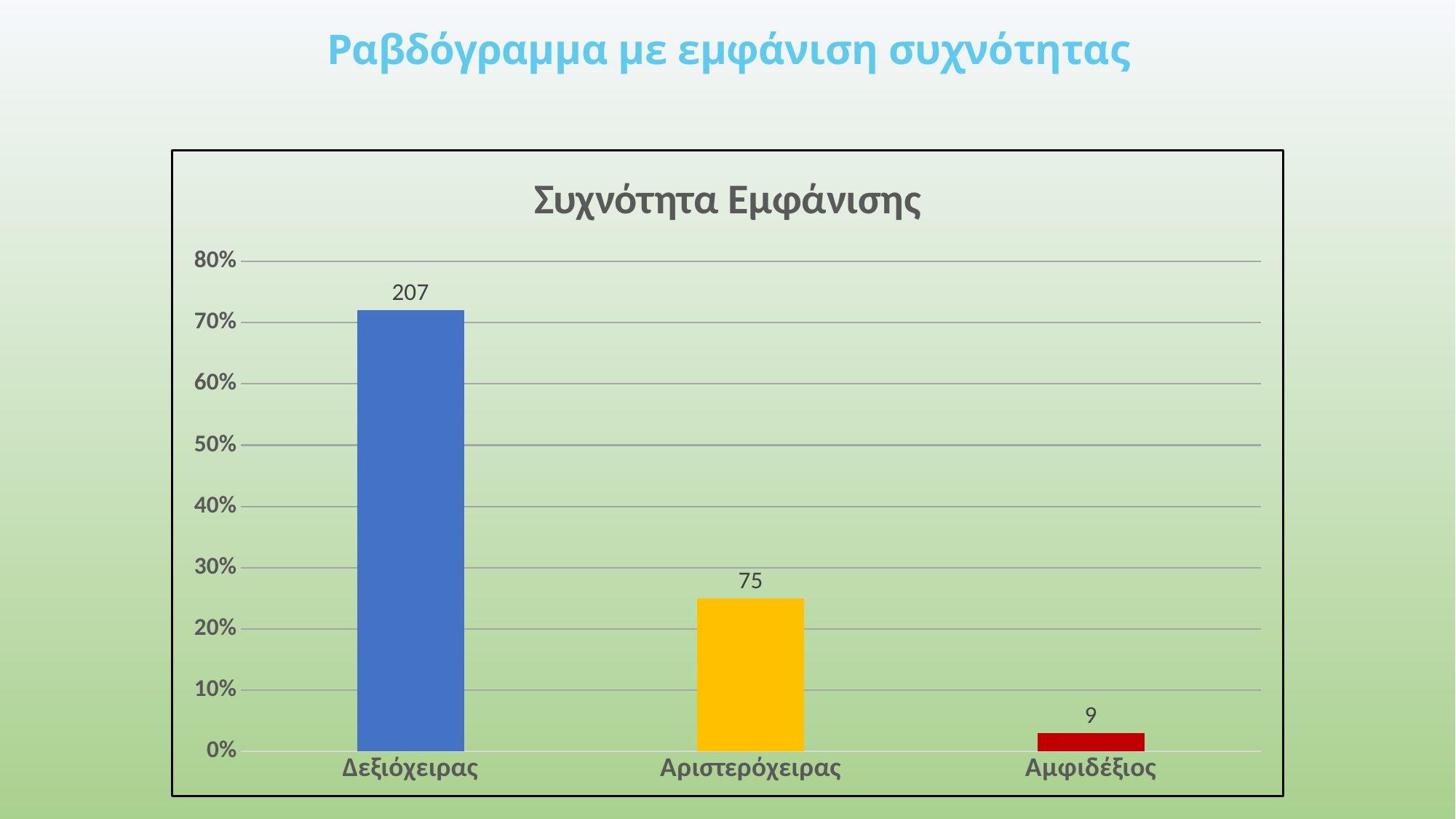
Is the bar for Δεξιόχειρας greater or less than 70% on the axis? greater What is the data label shown for Αριστερόχειρας? 75 What is the difference between the data labels for Δεξιόχειρας and Αριστερόχειρας? 132 What is the difference between the data labels for Αριστερόχειρας and Αμφιδέξιος? 66 What is the data label shown for Δεξιόχειρας? 207 What is the data label shown for Αμφιδέξιος? 9 How many categories are shown on the x axis? 3 What type of chart is shown? Bar chart Which is larger, the bar for Αριστερόχειρας or the bar for Αμφιδέξιος? Αριστερόχειρας Is the bar for Αριστερόχειρας greater or less than 30% on the axis? less Which category has the lowest bar? Αμφιδέξιος Which category has the highest bar? Δεξιόχειρας